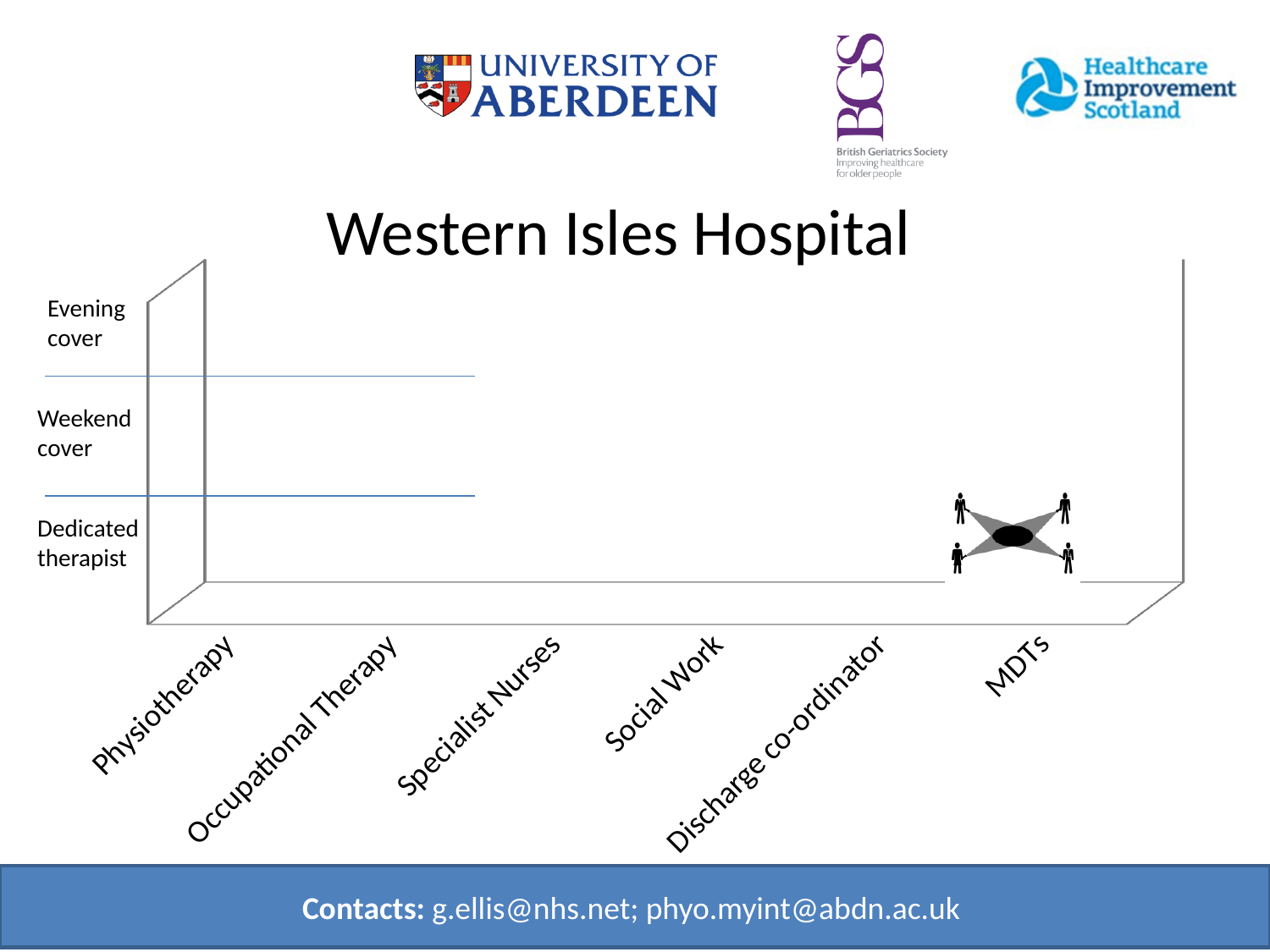
How many levels are labelled on the vertical axis of the chart? 3 What is the title of the chart? Western Isles Hospital Which category sits between Specialist Nurses and Discharge co-ordinator on the x axis? Social Work What is the highest level labelled on the vertical axis of the chart? Evening cover What is the last category on the x axis of the chart? MDTs How many categories are listed along the x axis of the chart? 6 What is the first category on the x axis of the chart? Physiotherapy Which category on the chart has a team icon plotted against it? MDTs At which vertical-axis level is the MDTs icon placed on the chart? Dedicated therapist